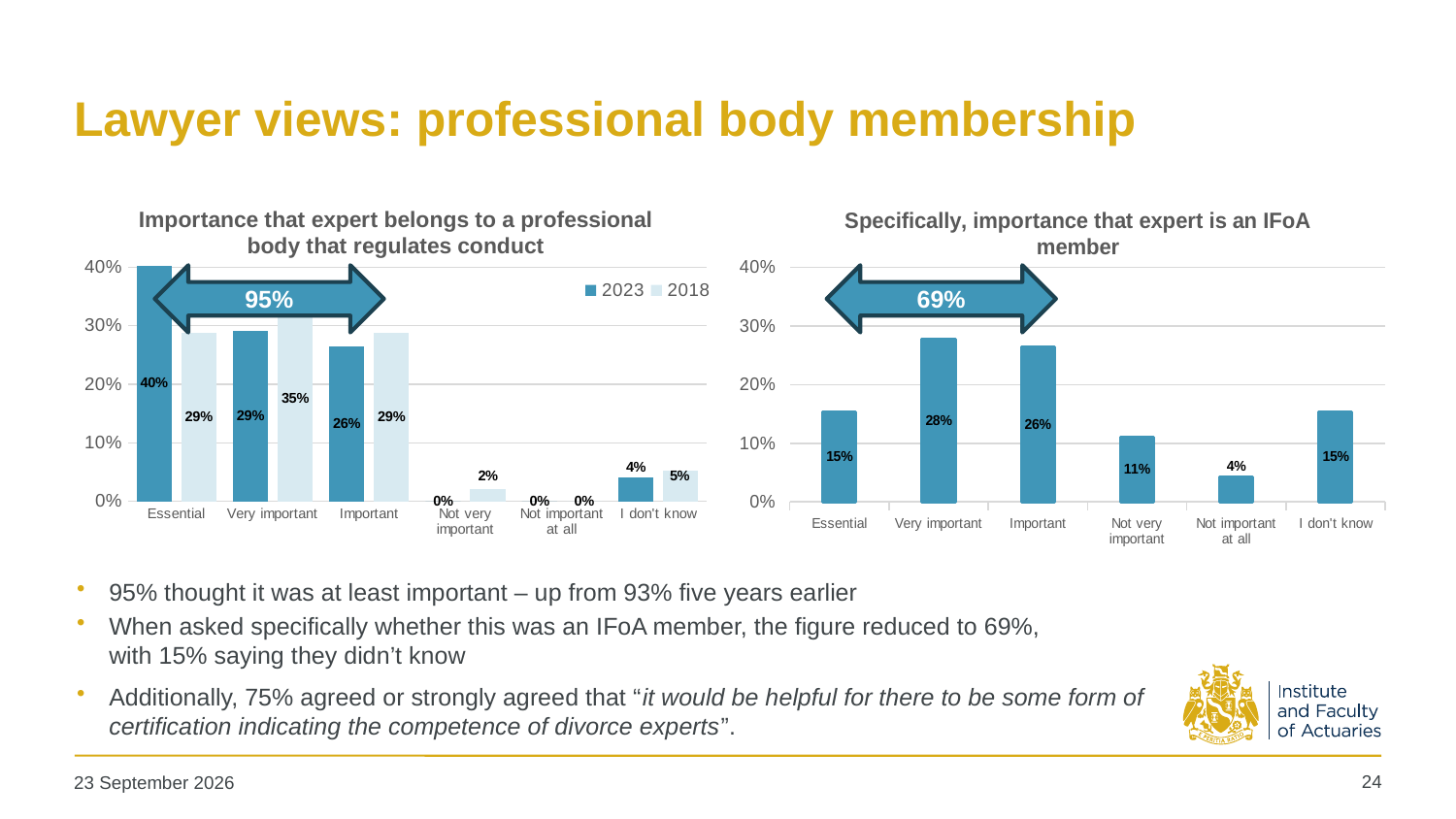
In the chart 'Specifically, importance that expert is an IFoA member', how many categories are shown on the x axis? 6 In the chart 'Importance that expert belongs to a professional body that regulates conduct', which category has the highest 2023 value? Essential In the chart 'Importance that expert belongs to a professional body that regulates conduct', is the 2023 value for Important larger or the 2018 value for Important? 2018 In the chart 'Specifically, importance that expert is an IFoA member', what is the value for Very important? 28% In the chart 'Importance that expert belongs to a professional body that regulates conduct', what is the 2018 value for Very important? 35% In the chart 'Importance that expert belongs to a professional body that regulates conduct', how many series does the legend list? 2 In the chart 'Importance that expert belongs to a professional body that regulates conduct', what is the 2023 value for Essential? 40% In the chart 'Specifically, importance that expert is an IFoA member', what is the difference between the values for Very important and Not very important? 17% What kind of chart is 'Specifically, importance that expert is an IFoA member'? Bar chart In the chart 'Specifically, importance that expert is an IFoA member', what is the value for Not important at all? 4% In the chart 'Specifically, importance that expert is an IFoA member', which category has the lowest value? Not important at all In the chart 'Importance that expert belongs to a professional body that regulates conduct', what is the difference between the 2023 and 2018 values for Essential? 11%